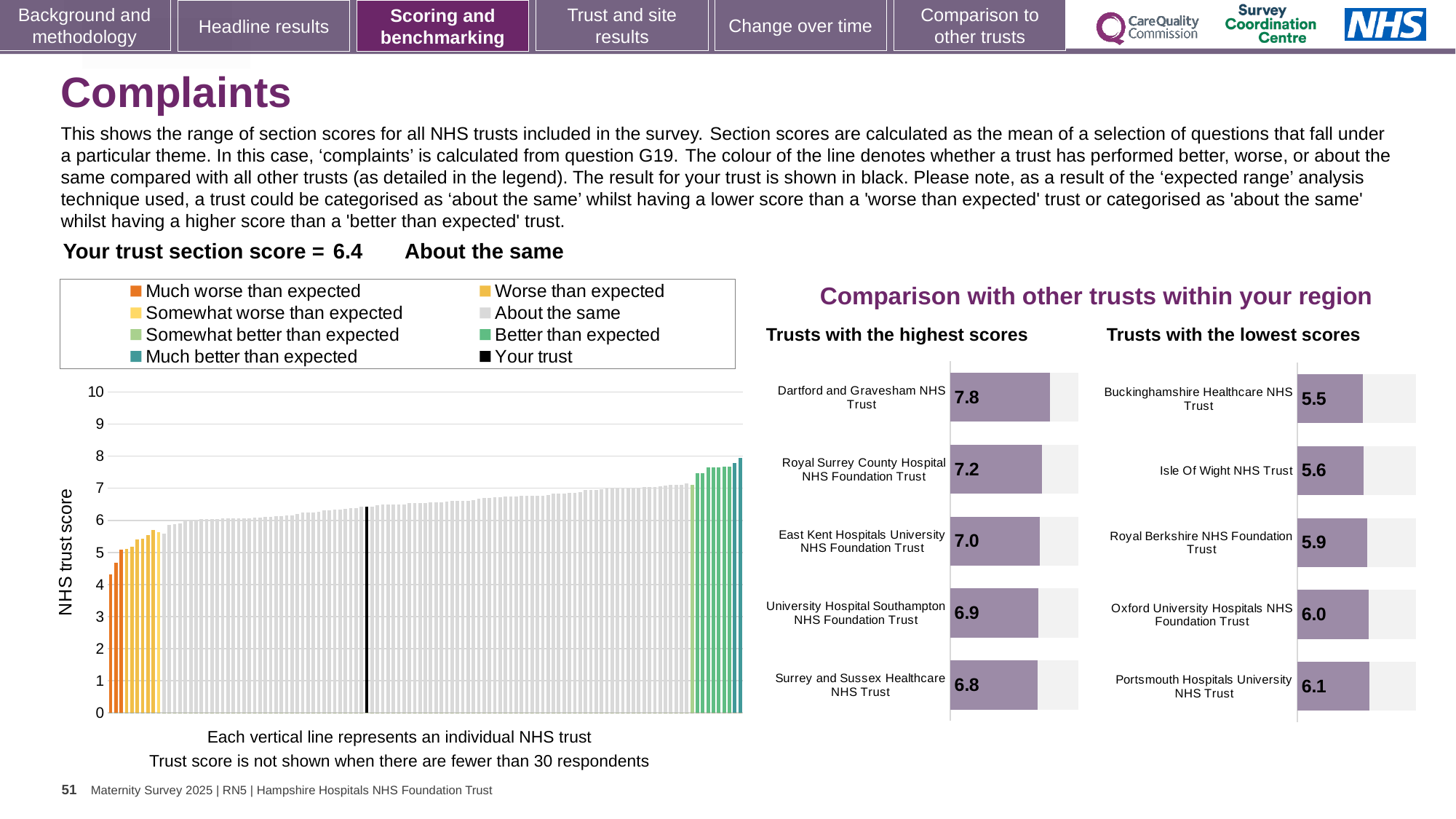
How many entries does the legend of the main 'NHS trust score' chart list? 8 In the 'Trusts with the highest scores' chart, what is the score for Dartford and Gravesham NHS Trust? 7.8 In the 'Trusts with the highest scores' chart, which trust has the lowest score? Surrey and Sussex Healthcare NHS Trust In the 'Trusts with the lowest scores' chart, which trust has the highest score? Portsmouth Hospitals University NHS Trust What kind of chart is the 'Trusts with the highest scores' chart? bar chart In the 'Trusts with the lowest scores' chart, what is the score for Royal Berkshire NHS Foundation Trust? 5.9 In the 'Trusts with the highest scores' chart, what is the difference between the scores of Dartford and Gravesham NHS Trust and Surrey and Sussex Healthcare NHS Trust? 1.0 In the main 'NHS trust score' chart on the left, what is the section score for your trust? 6.4 In the main 'NHS trust score' chart on the left, is the value of the leftmost (lowest) bar greater or less than 5? less In the main 'NHS trust score' chart on the left, do the bar values rise or fall from left to right? rise How many trusts are shown in the 'Trusts with the lowest scores' chart? 5 In the 'Trusts with the lowest scores' chart, which has the larger score: Isle Of Wight NHS Trust or Oxford University Hospitals NHS Foundation Trust? Oxford University Hospitals NHS Foundation Trust